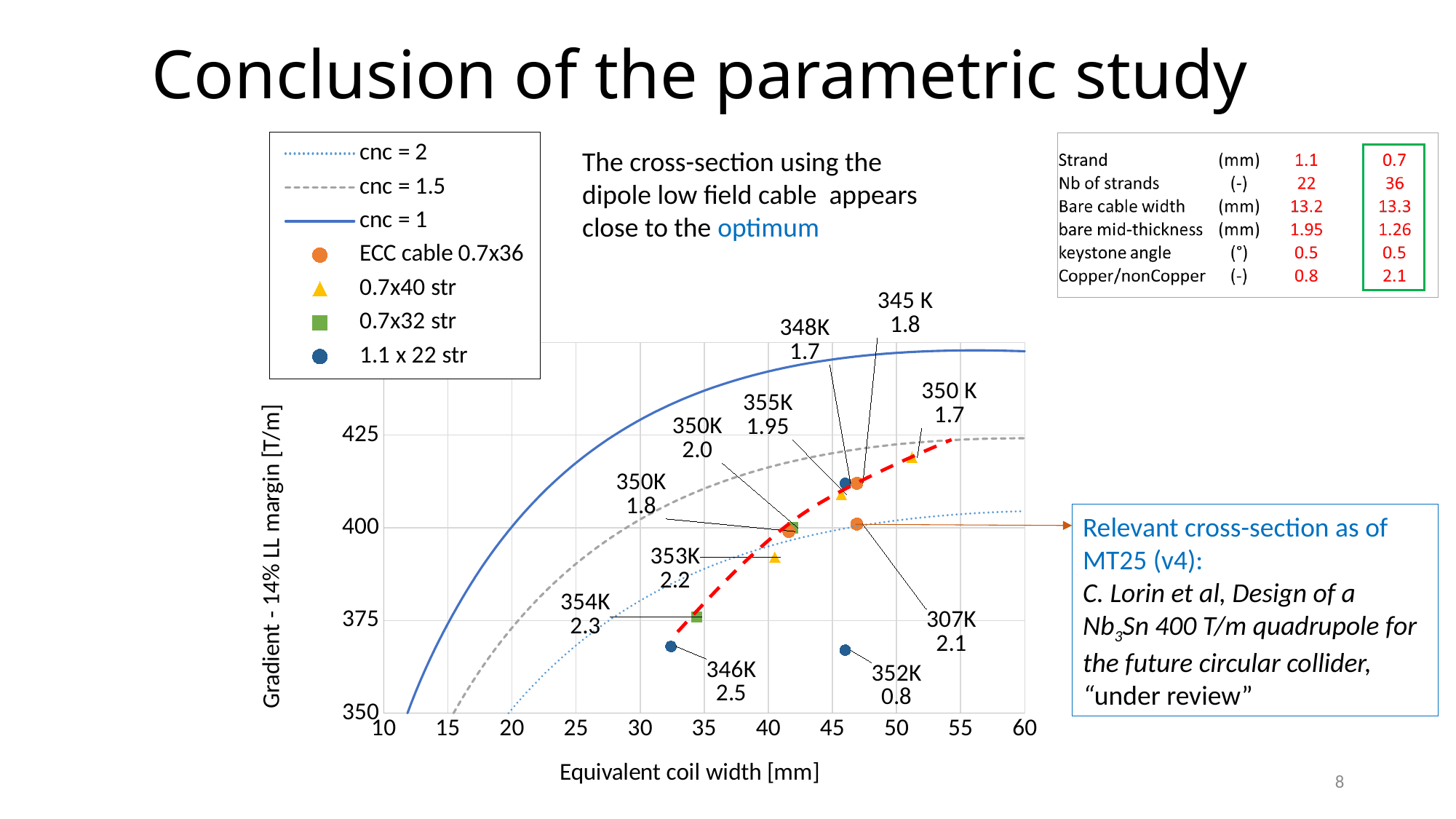
Which curve lies higher on the chart, cnc = 1 or cnc = 1.5? cnc = 1 Which curve lies lowest on the chart, cnc = 1, cnc = 1.5 or cnc = 2? cnc = 2 What is the label of the y axis of the chart? Gradient - 14% LL margin [T/m] Is the gradient of the 0.7x40 str point labelled 350 K 1.7 greater or less than 400 T/m? greater What is the label of the x axis of the chart? Equivalent coil width [mm] Is the gradient of the 1.1 x 22 str point labelled 346K 2.5 greater or less than 375 T/m? less Which legend entry is drawn as a solid blue line? cnc = 1 Is the gradient of the 1.1 x 22 str point labelled 352K 0.8 greater or less than 375 T/m? less What is the highest value shown on the y axis of the chart? 425 Does the cnc = 1 curve rise or fall as the equivalent coil width increases? rise How many entries does the chart legend list? 7